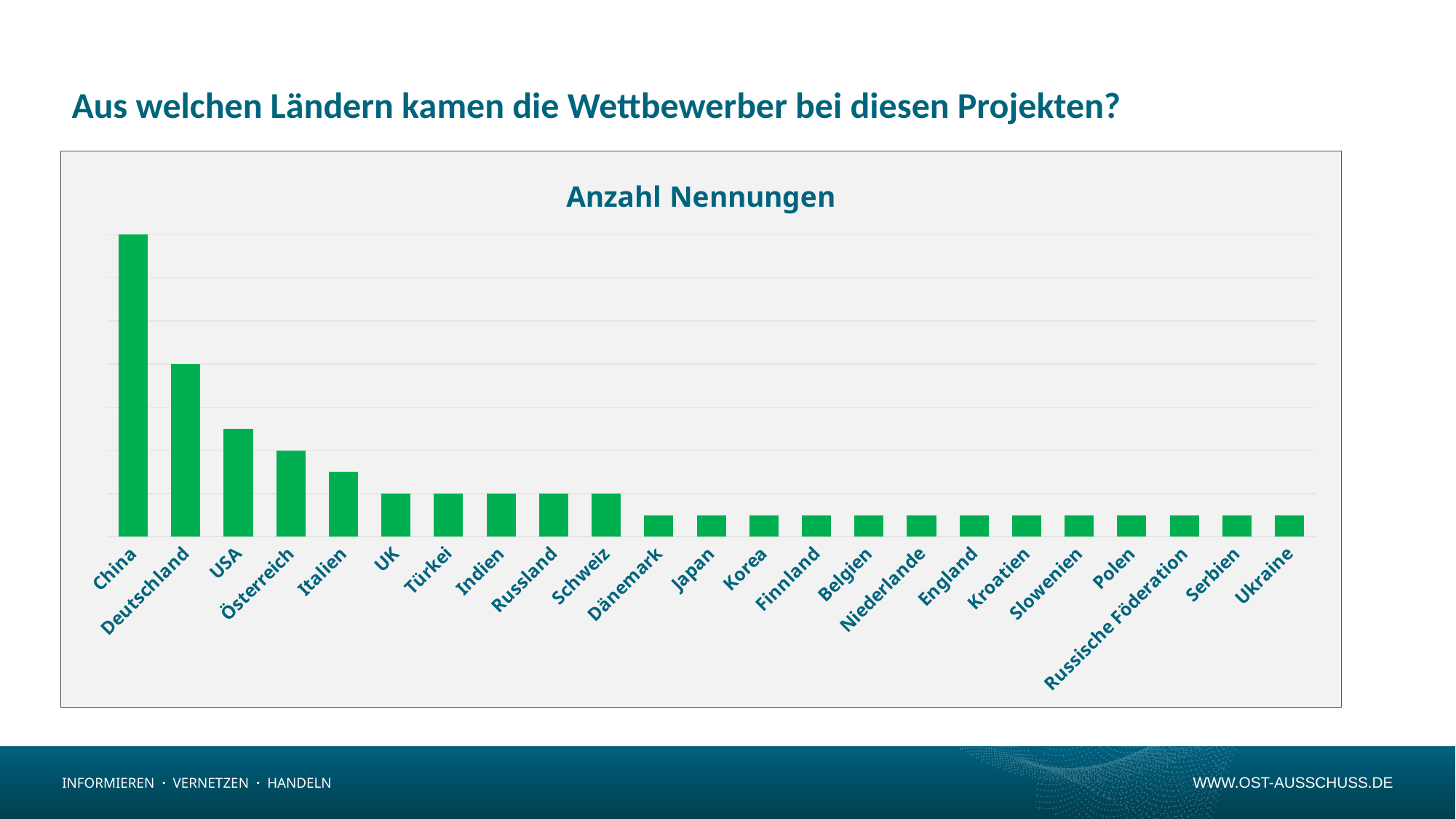
How many countries are shown on the x axis of the chart? 23 What kind of chart is shown on the slide? bar chart Which has the larger value, Schweiz or Dänemark? Schweiz Which country has the second-highest bar in the chart? Deutschland Which country has the highest number of mentions (Anzahl Nennungen)? China Which has the larger value, China or Deutschland? China Which has the larger value, Deutschland or USA? Deutschland What is the title of the chart? Anzahl Nennungen What colour are the bars in the chart? green Do the values rise or fall from left to right along the x axis? fall